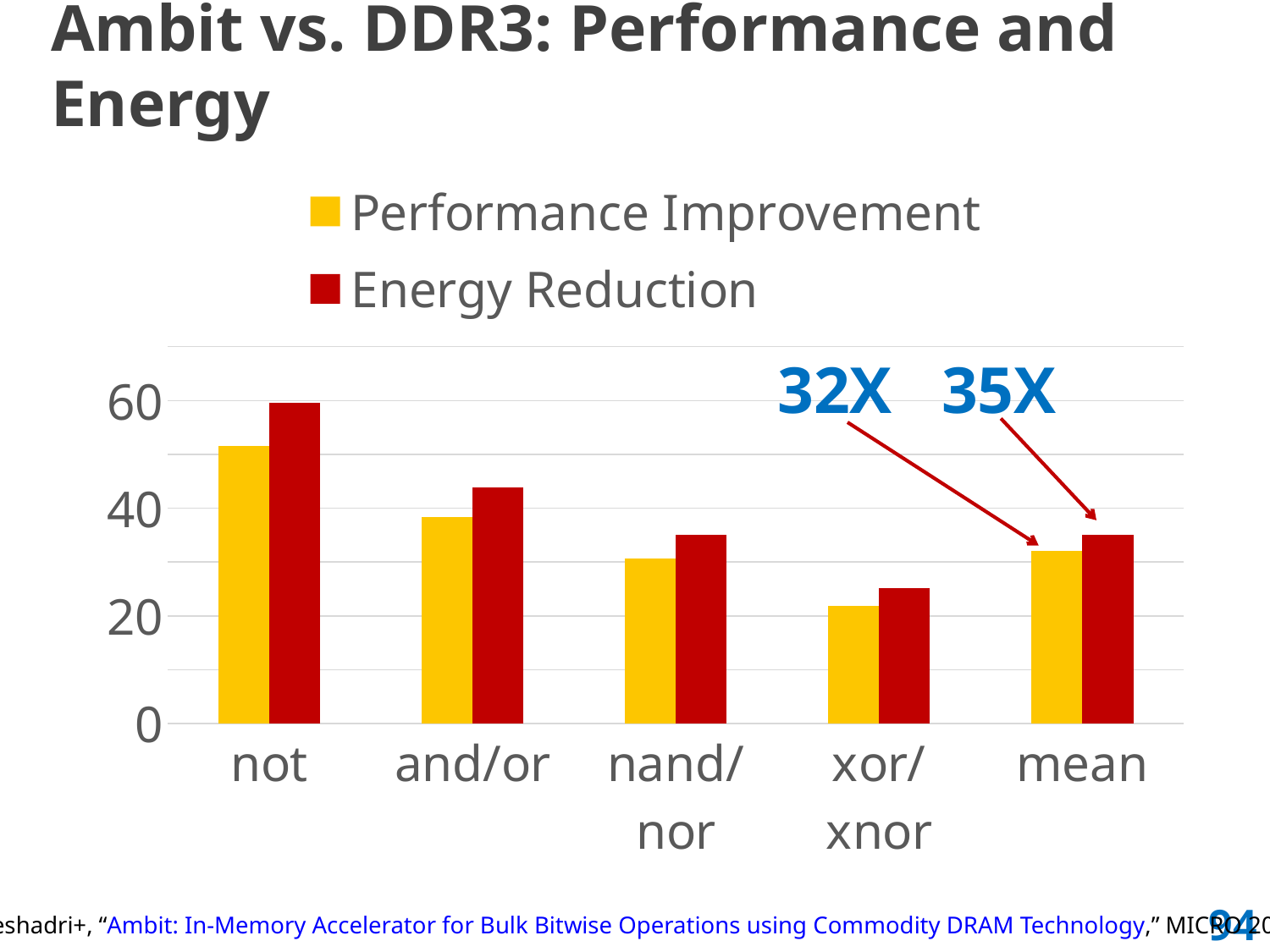
How many series does the legend list? 2 Which operation has the lowest Energy Reduction? xor/xnor Is the Performance Improvement for 'xor/xnor' greater or less than 40? less Do the Performance Improvement values rise or fall from 'not' to 'xor/xnor'? fall Which operation has the highest Performance Improvement? not What kind of chart is shown on the slide? bar chart What is the mean Performance Improvement shown on the chart? 32X How many categories are shown on the x axis? 5 What is the mean Energy Reduction shown on the chart? 35X Is the Energy Reduction for 'not' greater or less than 40? greater For the 'not' operation, which is larger: Performance Improvement or Energy Reduction? Energy Reduction What is the difference between the mean Energy Reduction and the mean Performance Improvement? 3X